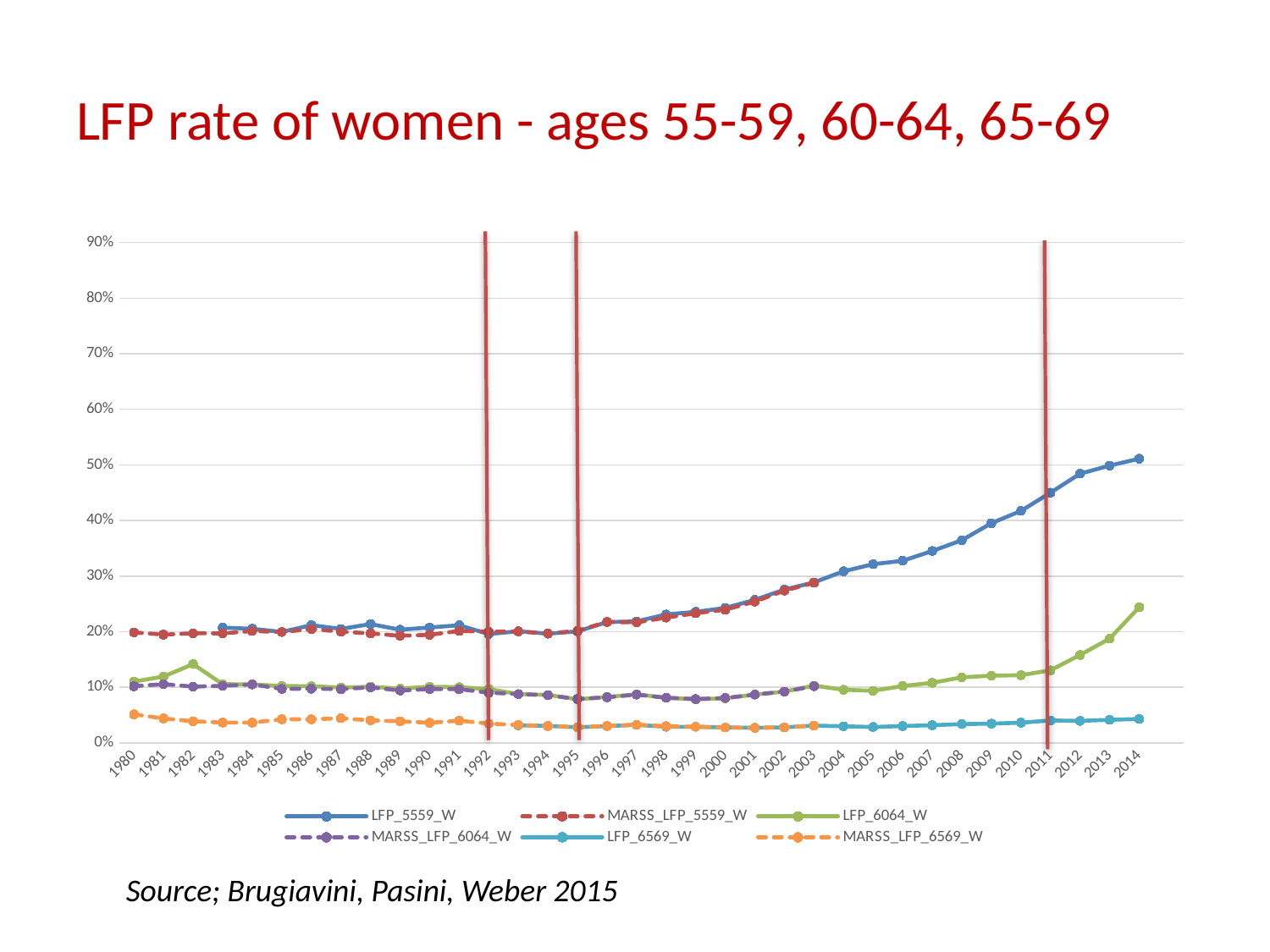
Is the value for LFP_5559_W in 2014 greater or less than 40%? greater In 2014, which is larger: LFP_5559_W or LFP_6064_W? LFP_5559_W What is the title of the chart? LFP rate of women - ages 55-59, 60-64, 65-69 How many years are plotted along the x axis? 35 Does the LFP_5559_W series rise or fall between 1995 and 2014? rise Which series has the highest value in 2014? LFP_5559_W How many series does the legend list? 6 Which series has the lowest value in 2014? LFP_6569_W Is the value for LFP_6064_W in 2014 greater or less than 20%? greater Is the value for LFP_6569_W in 2014 greater or less than 10%? less What kind of chart is shown on the slide? line chart